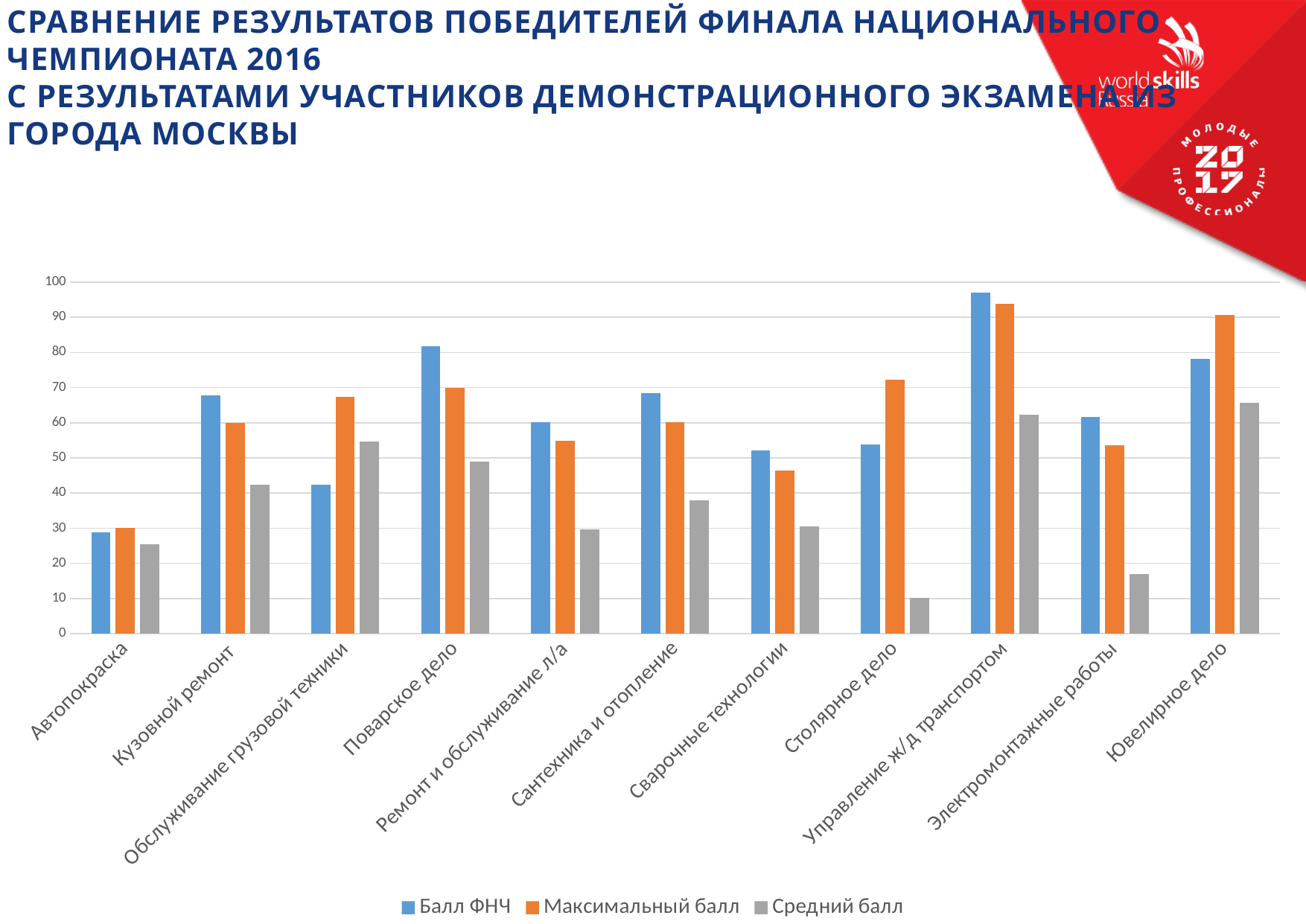
Which category has the lowest value for Средний балл? Столярное дело How many categories (competencies) are shown on the x axis? 11 Is the Средний балл value for Сантехника и отопление greater or less than 40? less Is the Средний балл value for Электромонтажные работы greater or less than 20? less Which category has the highest value for Балл ФНЧ? Управление ж/д транспортом Which category has the highest value for Максимальный балл? Управление ж/д транспортом What kind of chart is shown on the slide? bar chart For Столярное дело, which is larger: Балл ФНЧ or Максимальный балл? Максимальный балл Is the Балл ФНЧ value for Поварское дело greater or less than 80? greater Which category has the lowest value for Балл ФНЧ? Автопокраска Which series is shown in orange in the legend? Максимальный балл How many series does the legend list? 3